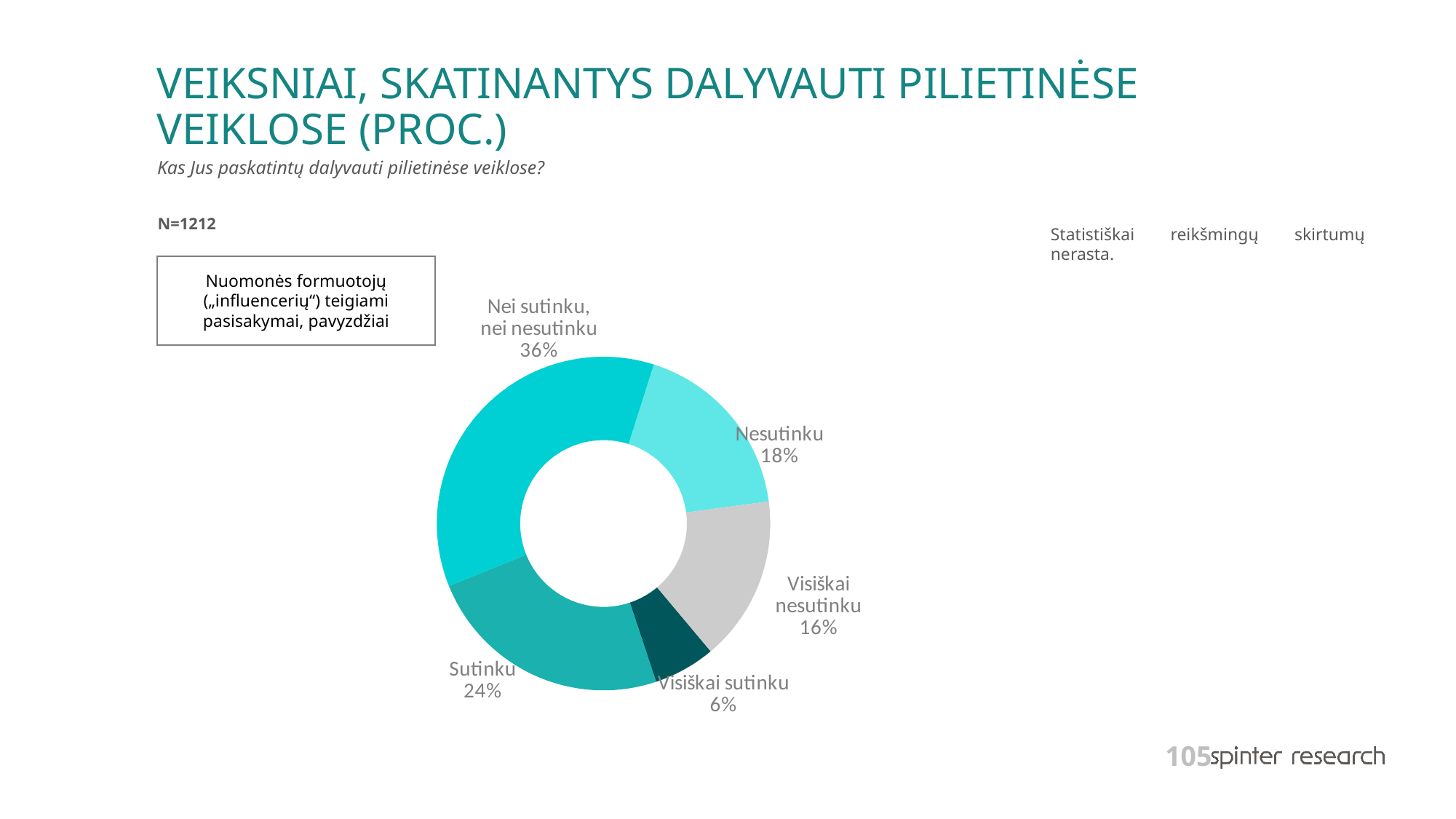
Which response category has the largest share of the chart? Nei sutinku, nei nesutinku What share of respondents answered "Sutinku"? 24% What share of respondents answered "Visiškai nesutinku"? 16% Which response category has the smallest share of the chart? Visiškai sutinku What share of respondents answered "Visiškai sutinku"? 6% What is the difference in percentage points between "Sutinku" and "Nesutinku"? 6 Which is larger, the share for "Nesutinku" or the share for "Visiškai nesutinku"? Nesutinku What share of respondents answered "Nei sutinku, nei nesutinku"? 36% What is the combined share of "Sutinku" and "Visiškai sutinku"? 30% What is the sample size (N) stated on the slide? N=1212 What kind of chart is shown on the slide? Doughnut (pie) chart How many response categories are shown in the chart? 5